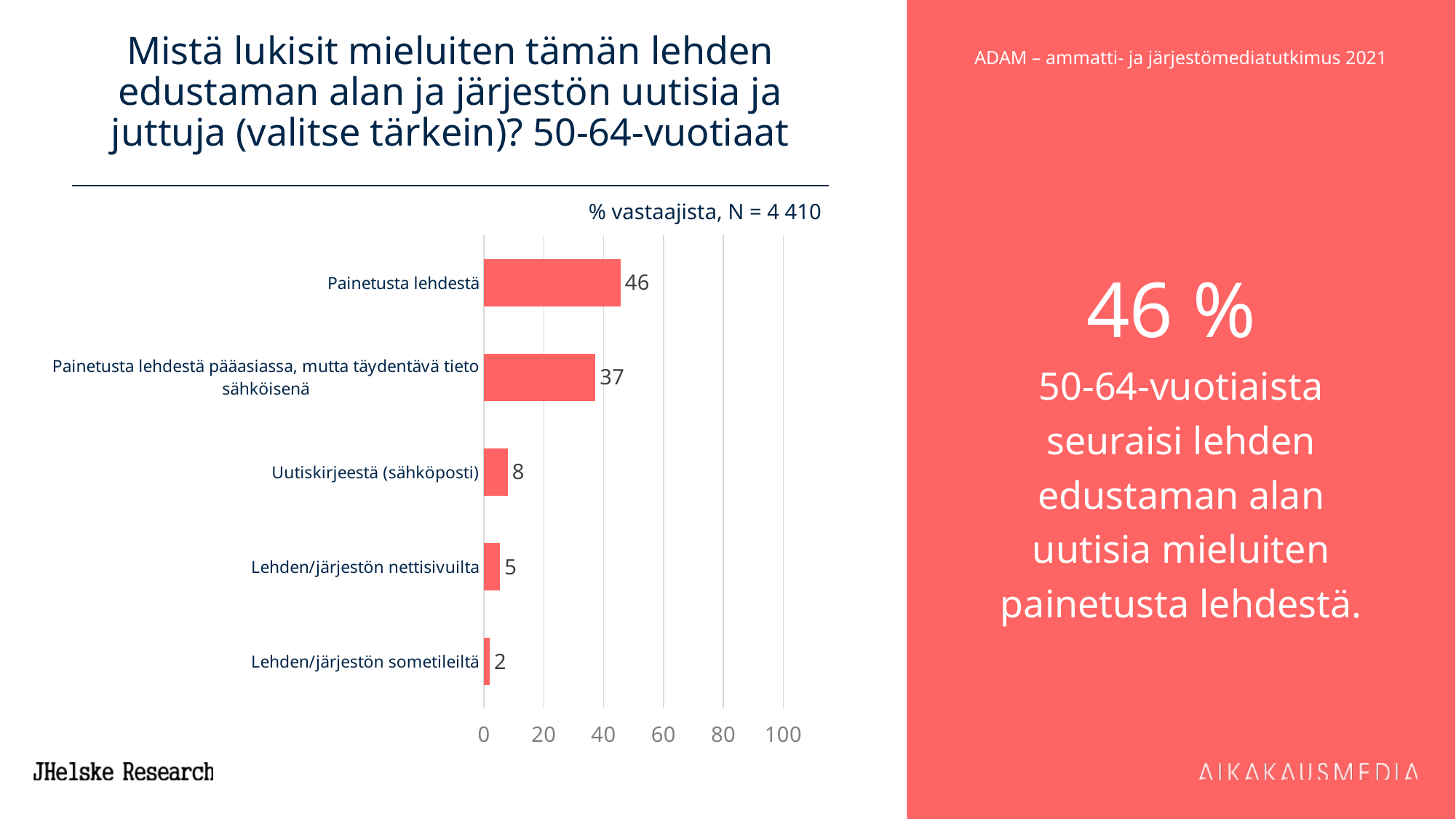
What is the value for "Uutiskirjeestä (sähköposti)"? 8 Which category has the highest value? Painetusta lehdestä Which category has the lowest value? Lehden/järjestön sometileiltä What is the value for "Painetusta lehdestä pääasiassa, mutta täydentävä tieto sähköisenä"? 37 What is the difference between the values for "Painetusta lehdestä" and "Painetusta lehdestä pääasiassa, mutta täydentävä tieto sähköisenä"? 9 What is the value for "Painetusta lehdestä"? 46 Which is larger: the value for "Uutiskirjeestä (sähköposti)" or the value for "Lehden/järjestön nettisivuilta"? Uutiskirjeestä (sähköposti) Is the value for "Painetusta lehdestä" greater or less than 40? greater What is the value for "Lehden/järjestön nettisivuilta"? 5 How many categories are shown in the chart? 5 What kind of chart is shown on the slide? bar chart What is the N (number of respondents) stated above the chart? 4 410